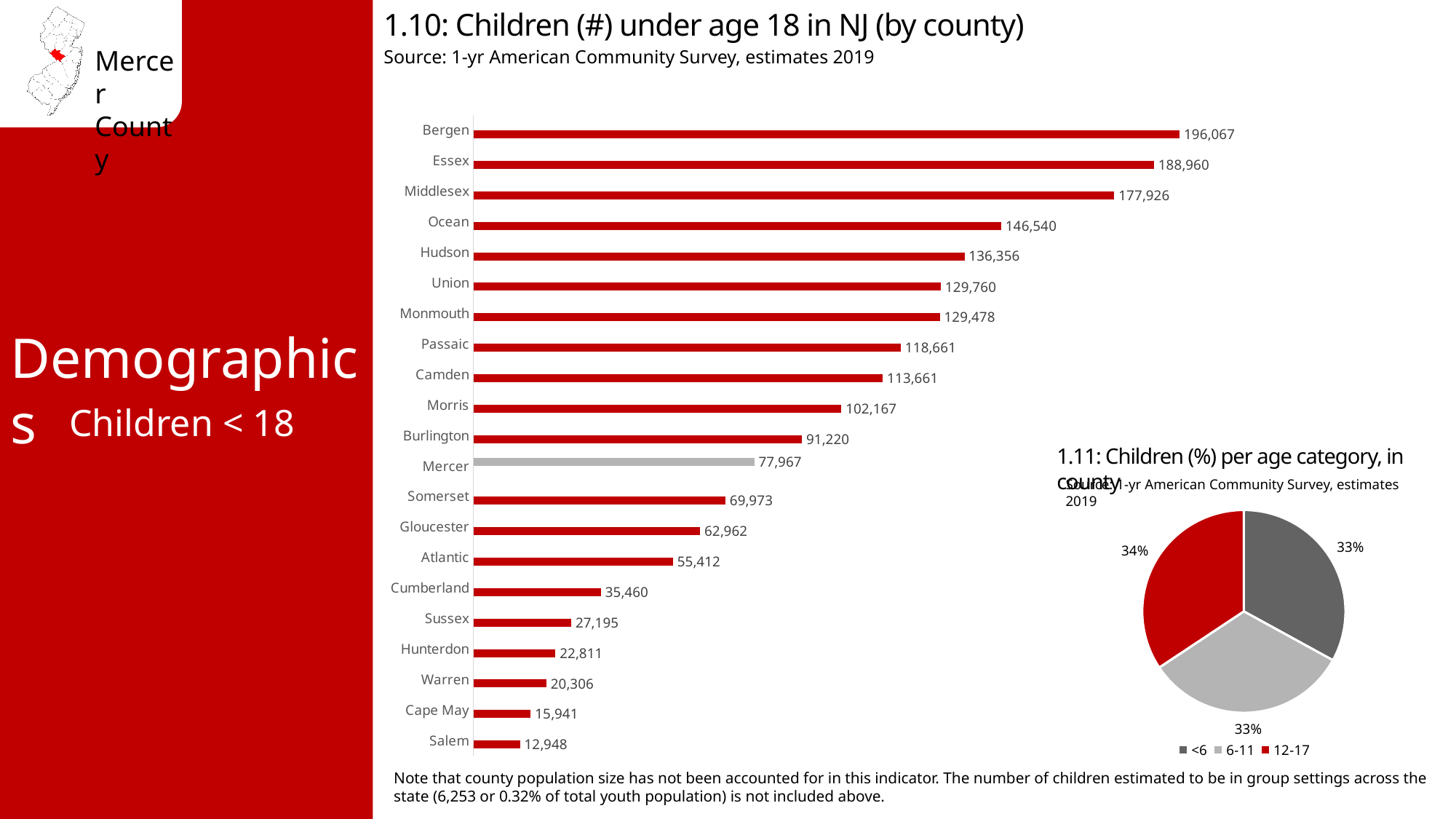
In the chart '1.10: Children (#) under age 18 in NJ (by county)', what is the value for Hudson? 136,356 In the pie chart '1.11: Children (%) per age category, in county', how many age categories does the legend list? 3 What kind of chart is '1.10: Children (#) under age 18 in NJ (by county)'? Bar chart In the chart '1.10: Children (#) under age 18 in NJ (by county)', what is the value for Mercer? 77,967 In the chart '1.10: Children (#) under age 18 in NJ (by county)', which county has the lowest number of children under 18? Salem In the chart '1.10: Children (#) under age 18 in NJ (by county)', which county has the highest number of children under 18? Bergen In the chart '1.10: Children (#) under age 18 in NJ (by county)', what is the difference between the values for Bergen and Essex? 7,107 In the pie chart '1.11: Children (%) per age category, in county', what share is the 12-17 age category? 34% In the chart '1.10: Children (#) under age 18 in NJ (by county)', which county's bar is coloured grey instead of red? Mercer In the chart '1.10: Children (#) under age 18 in NJ (by county)', how many counties are shown? 21 What kind of chart is '1.11: Children (%) per age category, in county'? Pie chart In the chart '1.10: Children (#) under age 18 in NJ (by county)', which has a larger value, Somerset or Gloucester? Somerset